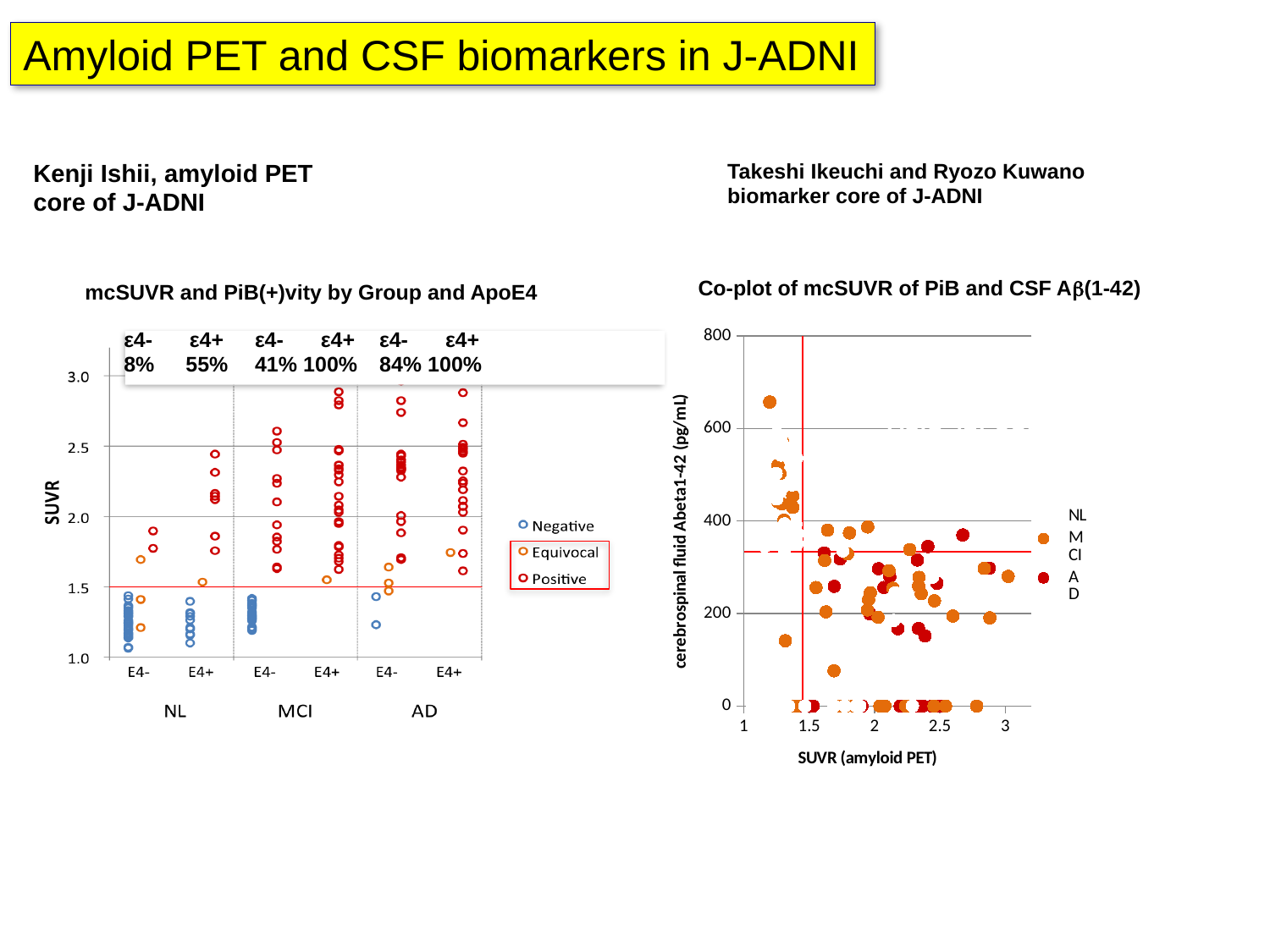
On the left chart (mcSUVR and PiB(+)vity by Group and ApoE4), what PiB positivity percentage is shown for the ε4+ NL group? 55% On the left chart (mcSUVR and PiB(+)vity by Group and ApoE4), which group has the lowest PiB positivity percentage? ε4- NL On the right chart (Co-plot of mcSUVR of PiB and CSF Aβ(1-42)), what is the label of the x axis? SUVR (amyloid PET) On the left chart (mcSUVR and PiB(+)vity by Group and ApoE4), what PiB positivity percentage is shown for the ε4- MCI group? 41% On the left chart (mcSUVR and PiB(+)vity by Group and ApoE4), how many E4 subgroups are shown along the x axis? 6 On the left chart (mcSUVR and PiB(+)vity by Group and ApoE4), which has a higher PiB positivity percentage, ε4- MCI or ε4- AD? ε4- AD On the left chart (mcSUVR and PiB(+)vity by Group and ApoE4), what is the difference between the PiB positivity percentages of the ε4+ MCI group and the ε4- NL group? 92% On the right chart (Co-plot of mcSUVR of PiB and CSF Aβ(1-42)), how many groups does the legend list? 3 On the left chart (mcSUVR and PiB(+)vity by Group and ApoE4), what PiB positivity percentage is shown for the ε4- NL group? 8% What kind of chart is the right chart (Co-plot of mcSUVR of PiB and CSF Aβ(1-42))? Scatter plot On the left chart (mcSUVR and PiB(+)vity by Group and ApoE4), what PiB positivity percentage is shown for the ε4- AD group? 84% On the left chart (mcSUVR and PiB(+)vity by Group and ApoE4), how many series does the legend list? 3